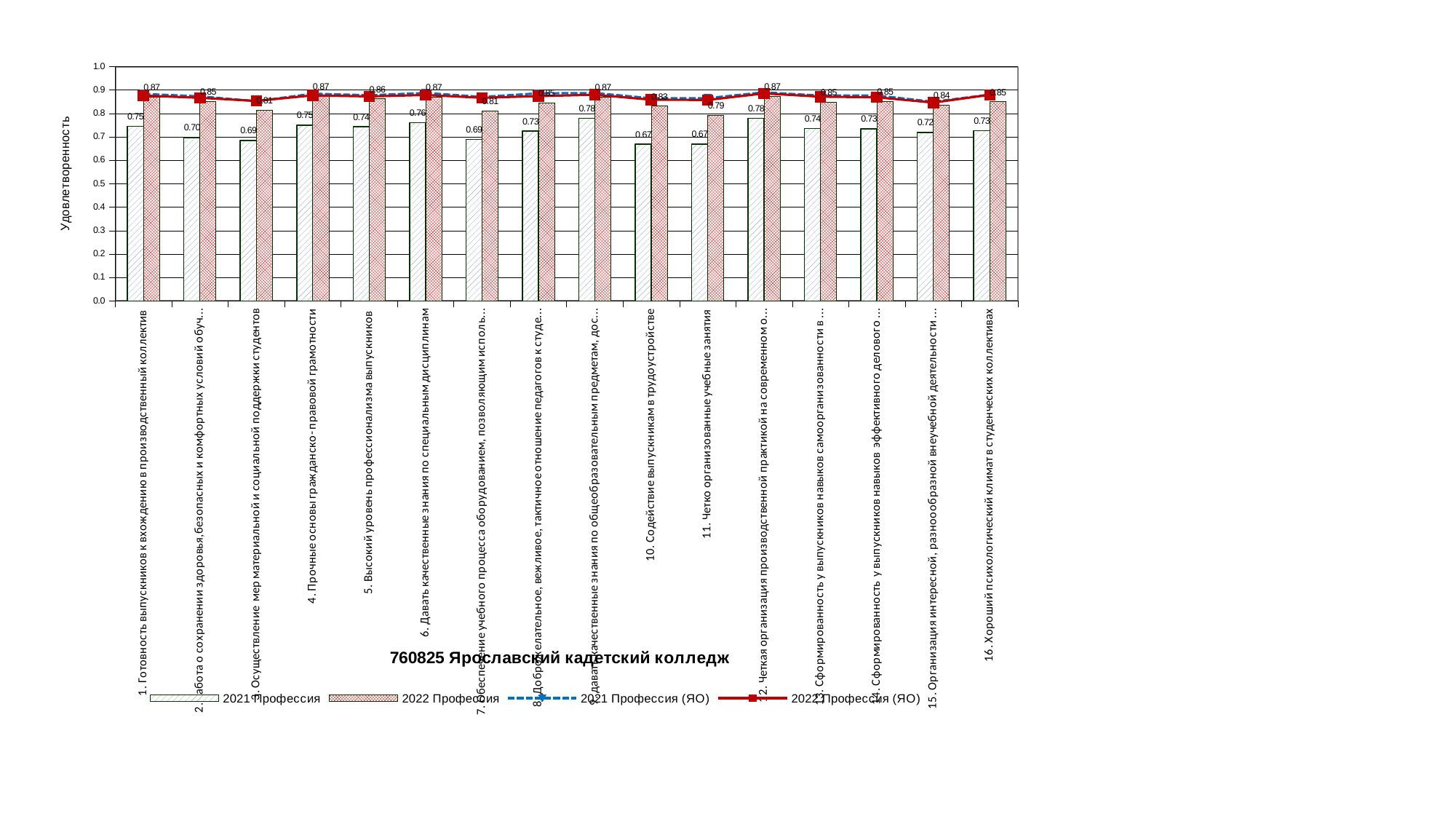
Which category has the lowest 2022 Профессия value? 11. Четко организованные учебные занятия For '5. Высокий уровень профессионализма выпускников', which is larger: the 2021 Профессия value or the 2022 Профессия value? 2022 Профессия What is the 2021 Профессия value for '10. Содействие выпускникам в трудоустройстве'? 0.67 How many series does the chart legend list? 4 How many categories are shown along the x axis? 16 Is the 2021 Профессия value for '10. Содействие выпускникам в трудоустройстве' greater or less than 0.7? less What is the 2022 Профессия value for '11. Четко организованные учебные занятия'? 0.79 What is the 2022 Профессия value for '16. Хороший психологический климат в студенческих коллективах'? 0.85 What is the label of the vertical axis? Удовлетворенность What is the title of the chart? 760825 Ярославский кадетский колледж What is the difference between the 2022 Профессия and 2021 Профессия values for '11. Четко организованные учебные занятия'? 0.12 What is the 2021 Профессия value for '1. Готовность выпускников к вхождению в производственный коллектив'? 0.75